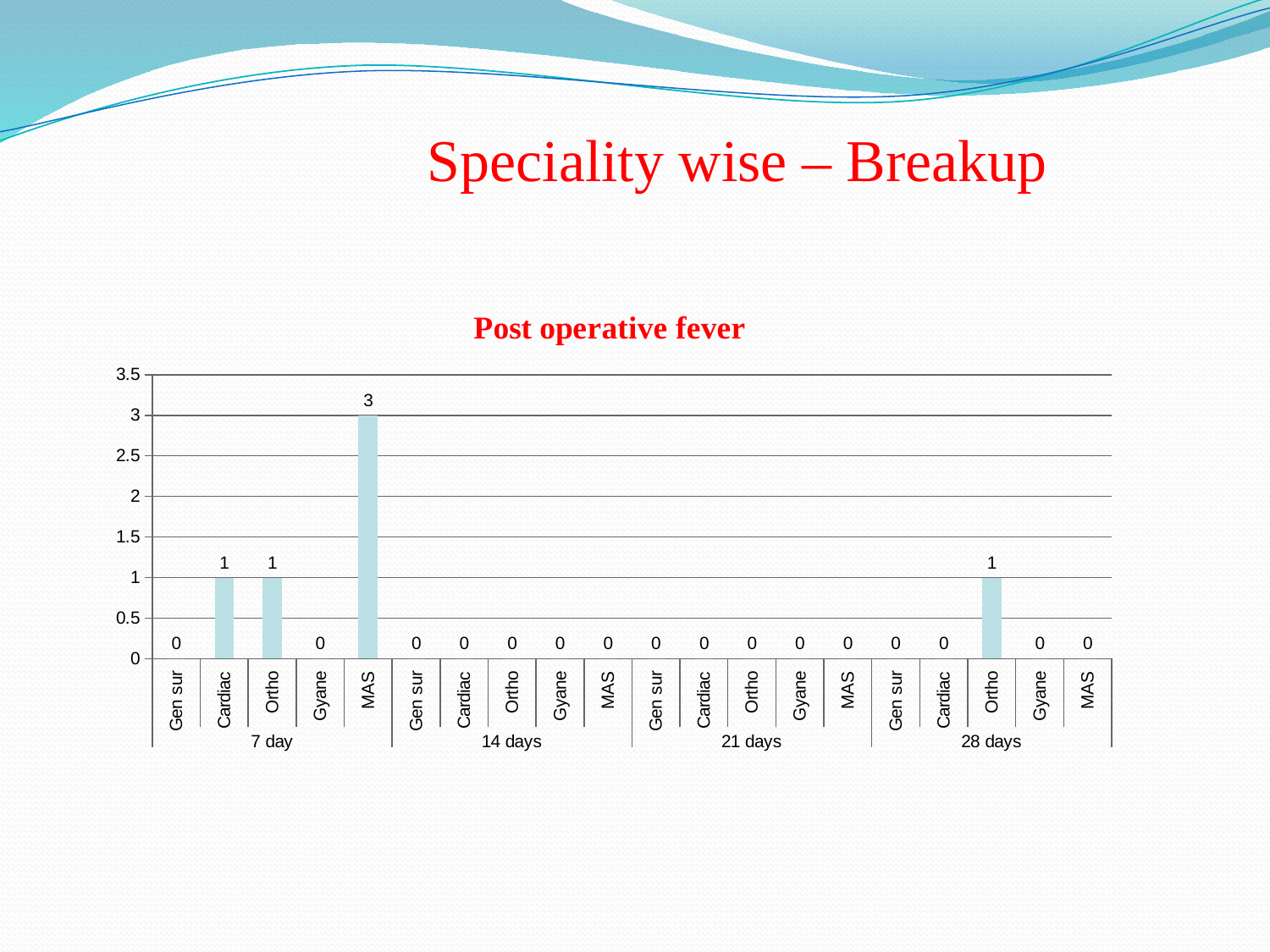
What is the value for Ortho in the 28 days group? 1 What is the difference between the value for MAS in the 7 day group and the value for Ortho in the 7 day group? 2 What is the value for Cardiac in the 7 day group? 1 What is the value for MAS in the 7 day group? 3 What kind of chart is shown on the slide? Bar chart What is the title of the chart? Post operative fever Is the value for MAS in the 7 day group greater or less than 2? greater How many time-period groups are shown on the x axis? 4 What is the value for Gen sur in the 14 days group? 0 Which category has the highest value in the chart? MAS (7 day) Which is larger: the value for MAS in the 7 day group or the value for Ortho in the 28 days group? MAS in the 7 day group